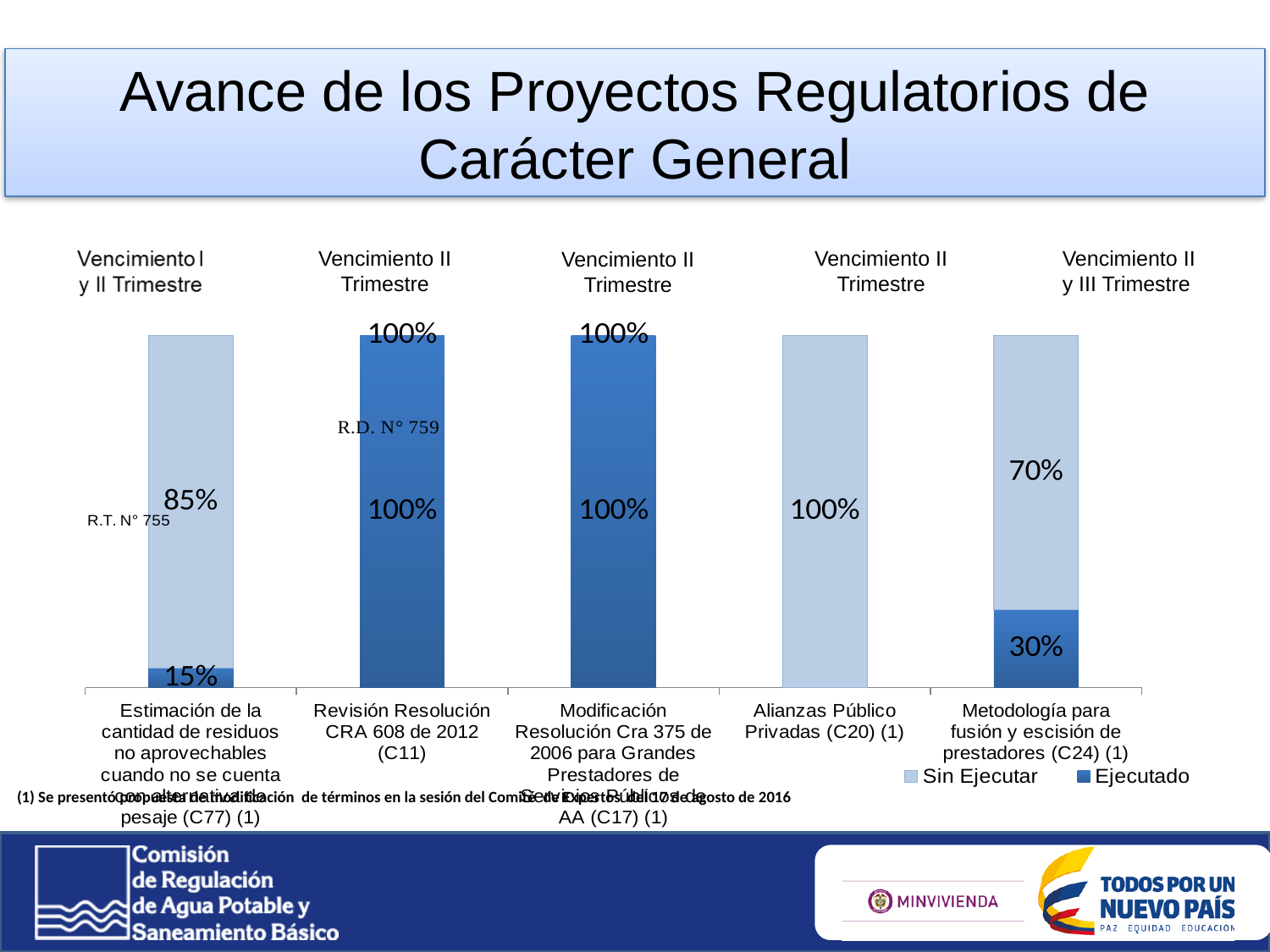
What is the Sin Ejecutar value for Alianzas Público Privadas (C20) (1)? 100% What is the Sin Ejecutar value for Metodología para fusión y escisión de prestadores (C24) (1)? 70% How many series does the legend list? 2 What is the total of the stacked bar for Metodología para fusión y escisión de prestadores (C24) (1)? 100% What kind of chart is shown on the slide? Stacked bar chart Which has a larger Ejecutado value: Metodología para fusión y escisión de prestadores (C24) (1) or Estimación de la cantidad de residuos no aprovechables (C77) (1)? Metodología para fusión y escisión de prestadores (C24) (1) What is the Ejecutado value for Metodología para fusión y escisión de prestadores (C24) (1)? 30% What is the Ejecutado value for Revisión Resolución CRA 608 de 2012 (C11)? 100% How many project categories are plotted on the x axis? 5 What is the Ejecutado value for Estimación de la cantidad de residuos no aprovechables (C77) (1)? 15% What are the two series named in the legend? Sin Ejecutar and Ejecutado What is the difference between the Sin Ejecutar and Ejecutado values for Estimación de la cantidad de residuos no aprovechables (C77) (1)? 70%